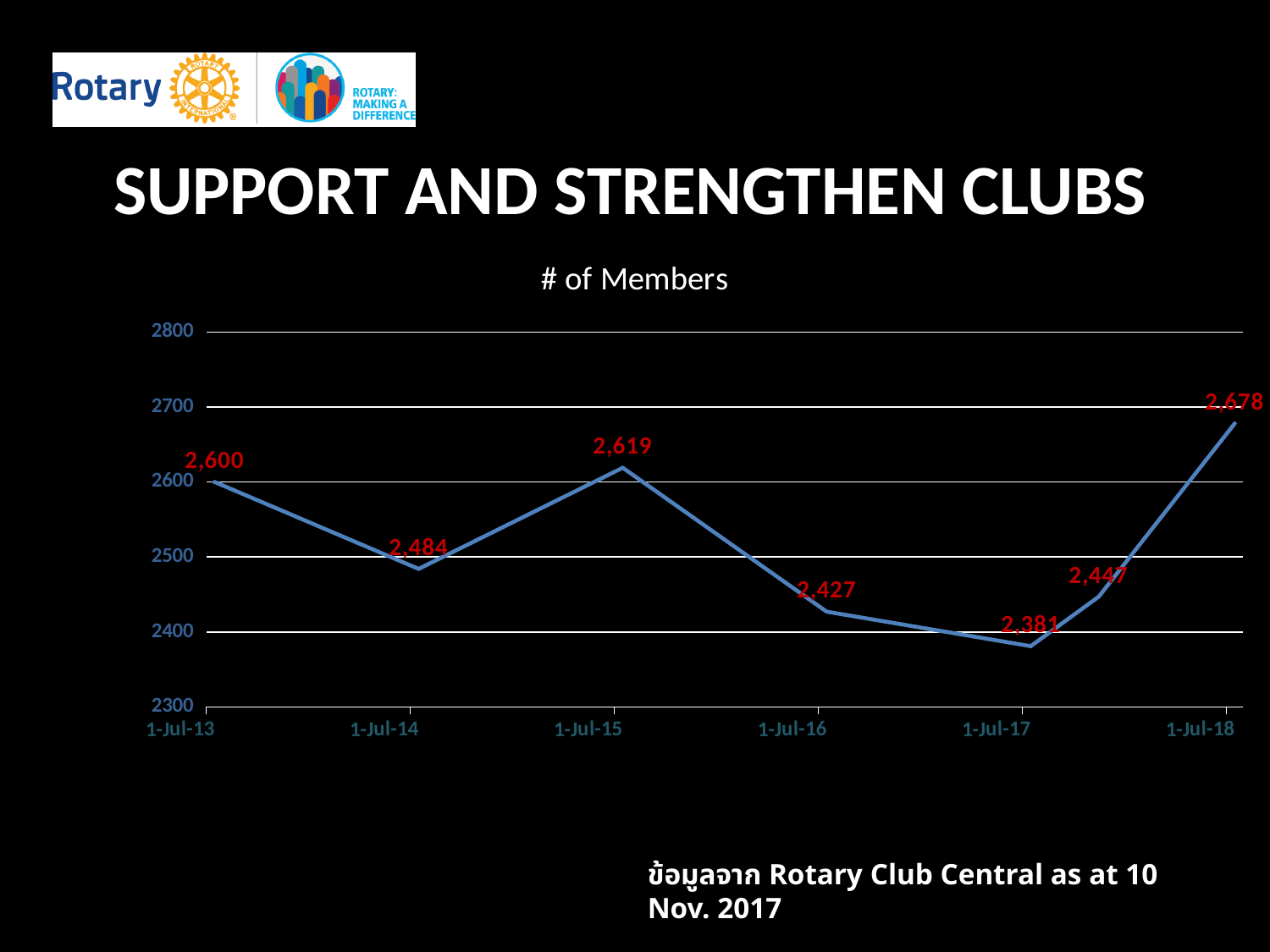
What kind of chart is shown on the slide? line chart Which date has more members, 1-Jul-14 or 1-Jul-16? 1-Jul-14 What is the title of the chart? # of Members What is the number of members on 1-Jul-13? 2,600 On which date is the number of members highest? 1-Jul-18 What is the number of members on 1-Jul-17? 2,381 By how much does the number of members on 1-Jul-18 exceed the number on 1-Jul-17? 297 Does the number of members rise or fall from 1-Jul-13 to 1-Jul-14? fall What is the number of members on 1-Jul-15? 2,619 On which date is the number of members lowest? 1-Jul-17 How many data points are plotted on the line? 7 What is the number of members on 1-Jul-16? 2,427